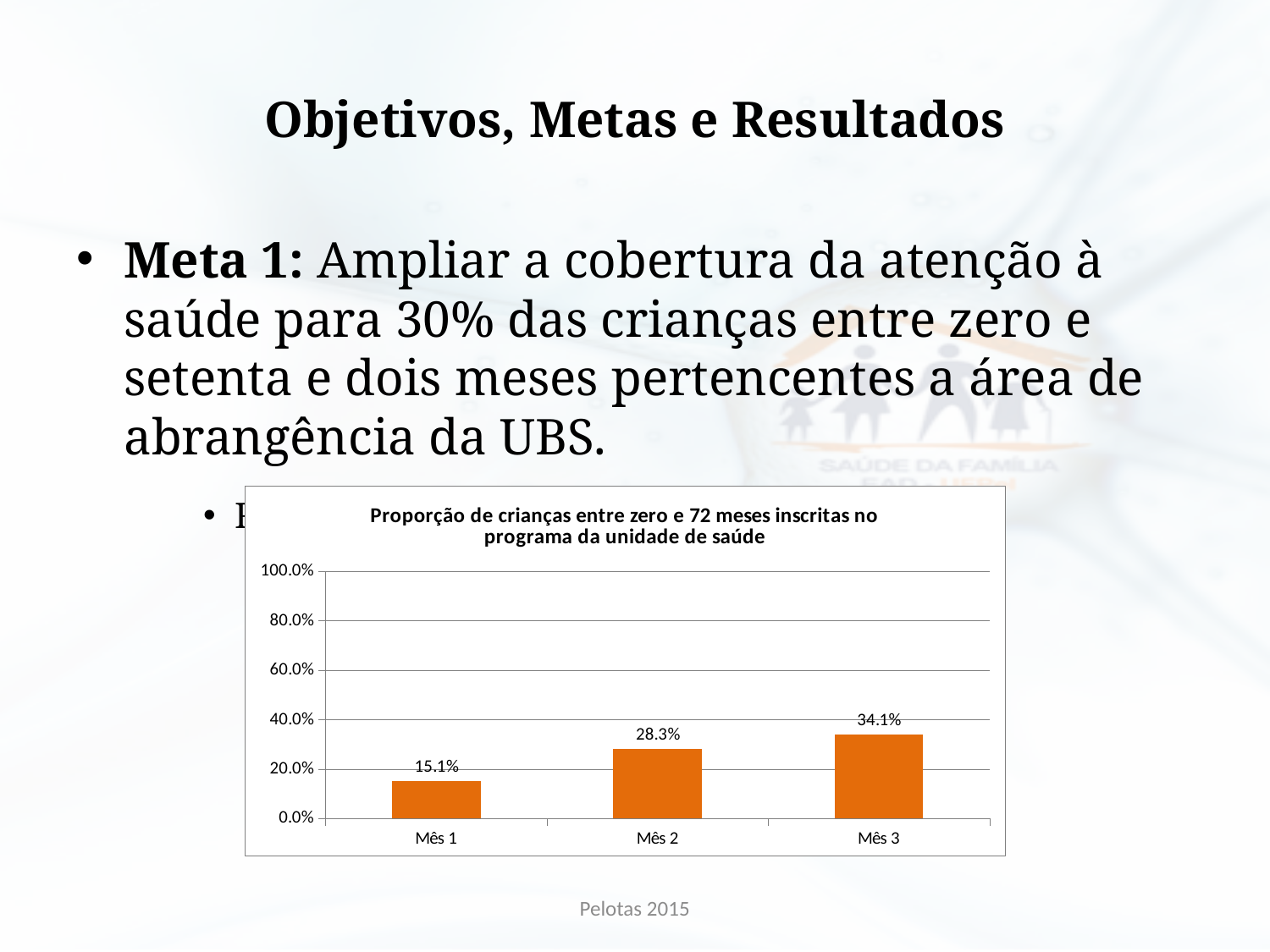
What is the difference between the values for Mês 2 and Mês 1? 13.2% What is the value for Mês 2? 28.3% What kind of chart is shown? bar chart Which month has the lowest value? Mês 1 What is the difference between the values for Mês 3 and Mês 1? 19.0% Do the values rise or fall from Mês 1 to Mês 3? rise Is the value for Mês 3 greater or less than 40.0%? less Which is larger, the value for Mês 2 or the value for Mês 3? Mês 3 Which month has the highest value? Mês 3 How many months are shown on the x axis? 3 What is the value for Mês 1? 15.1% What is the value for Mês 3? 34.1%